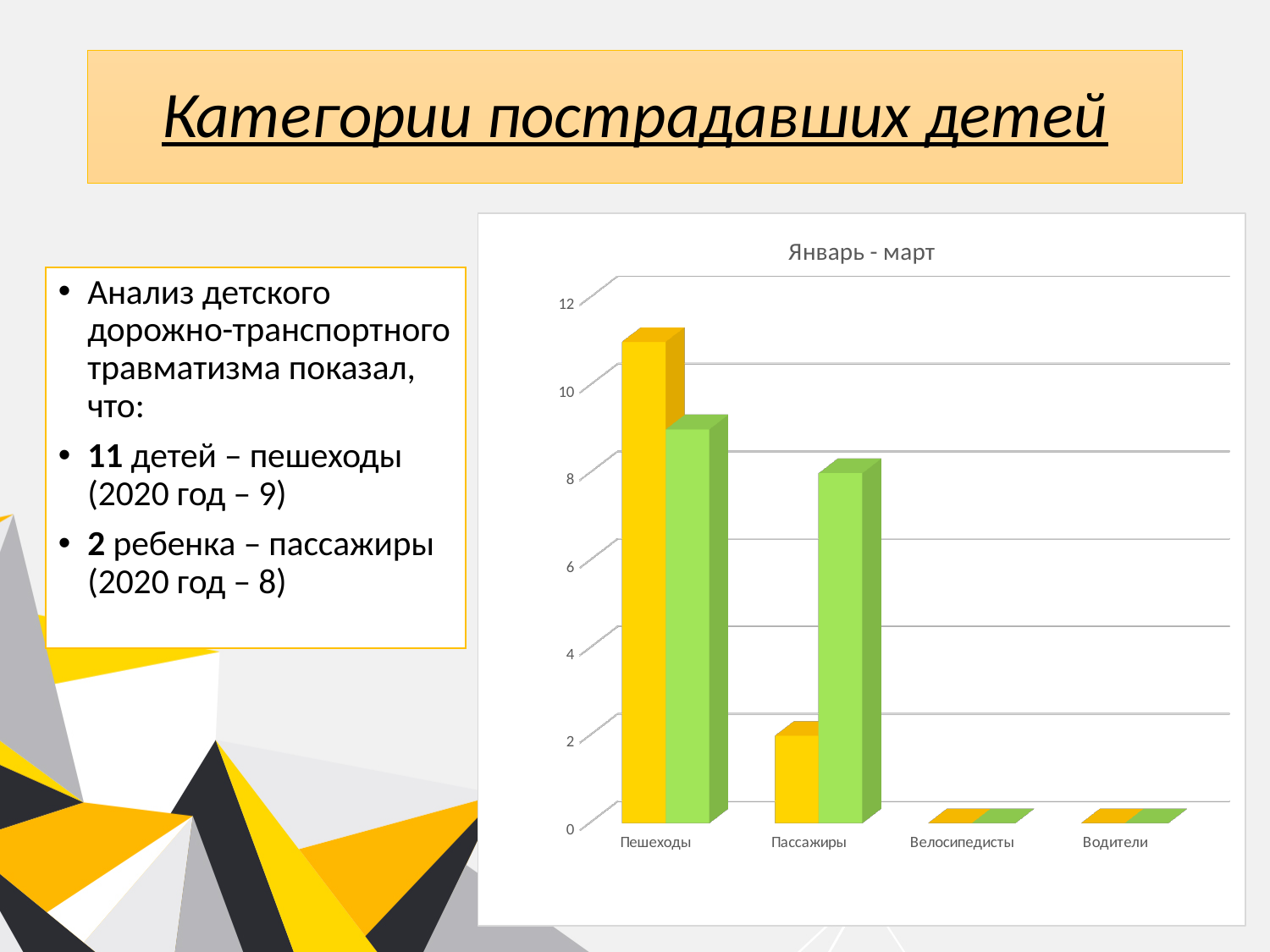
For Пешеходы, which bar is taller, the yellow one or the green one? yellow What kind of chart is shown on the slide? bar chart What is the title of the chart? Январь - март Which categories have bars at 0 in the chart? Велосипедисты and Водители Is the green bar for Пешеходы greater or less than 10? less What is the highest value shown on the vertical axis of the chart? 12 Is the green bar for Пассажиры greater or less than 6? greater How many categories are shown on the x axis of the chart? 4 Is the yellow bar for Пешеходы greater or less than 10? greater Which category has the tallest bar in the chart? Пешеходы For Пассажиры, which bar is taller, the yellow one or the green one? green